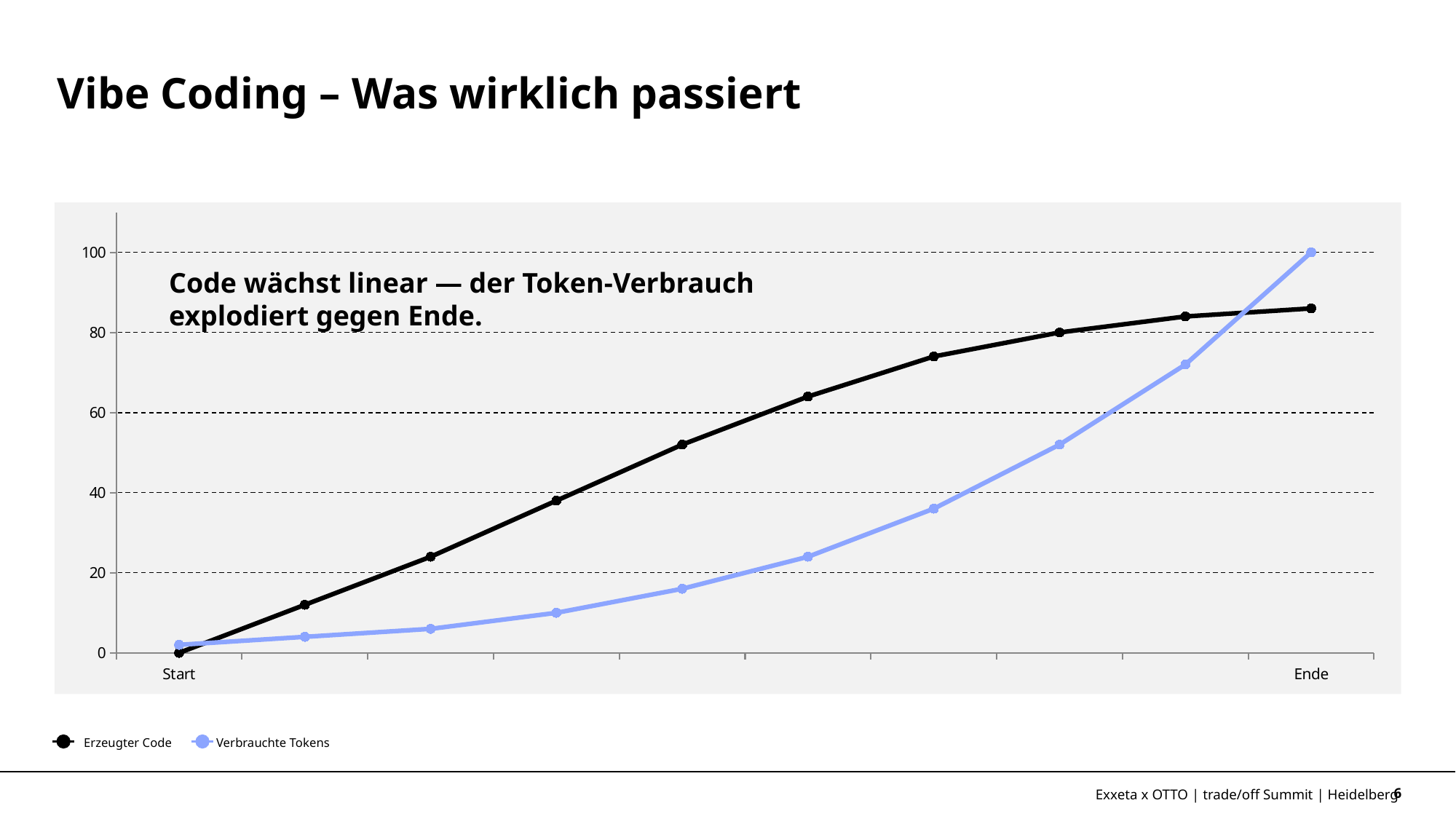
What is the value of Verbrauchte Tokens at Ende? 100 What kind of chart is shown on the slide? line chart Which series reaches the highest value on the chart? Verbrauchte Tokens Is the value of Erzeugter Code at Ende greater or less than 80? greater How many series does the chart legend list? 2 Is the value of Verbrauchte Tokens at Start greater or less than 20? less What are the two series named in the legend? Erzeugter Code and Verbrauchte Tokens What colour is the Verbrauchte Tokens line? blue At Ende, which series has the higher value, Erzeugter Code or Verbrauchte Tokens? Verbrauchte Tokens Do the values of Verbrauchte Tokens rise or fall from Start to Ende? rise How many data points does each series have? 10 What is the value of Erzeugter Code at Start? 0